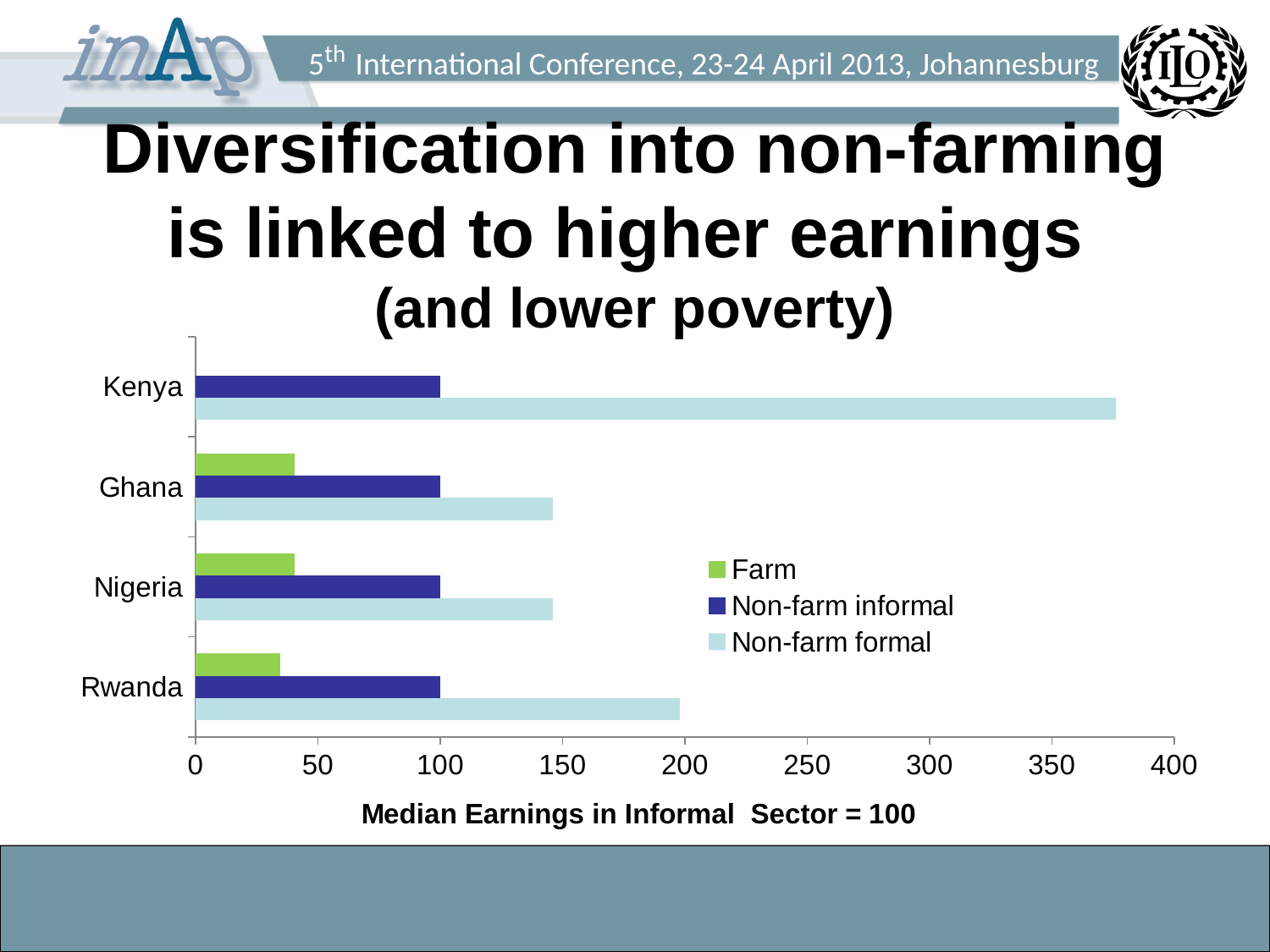
What is the Non-farm informal value for Ghana? 100 What is the Non-farm informal value for Kenya? 100 Which is larger: the Non-farm formal value for Kenya or the Non-farm formal value for Rwanda? Kenya Is the Non-farm formal value for Kenya greater or less than 350? greater Which country has the highest Non-farm formal value? Kenya What is the title of the horizontal axis? Median Earnings in Informal Sector = 100 Is the Non-farm formal value for Rwanda greater or less than 150? greater How many series does the legend list? 3 What kind of chart is shown on the slide? bar chart Is the Farm value for Nigeria greater or less than 50? less How many countries are shown on the chart? 4 For Rwanda, which is larger: the Farm value or the Non-farm formal value? Non-farm formal